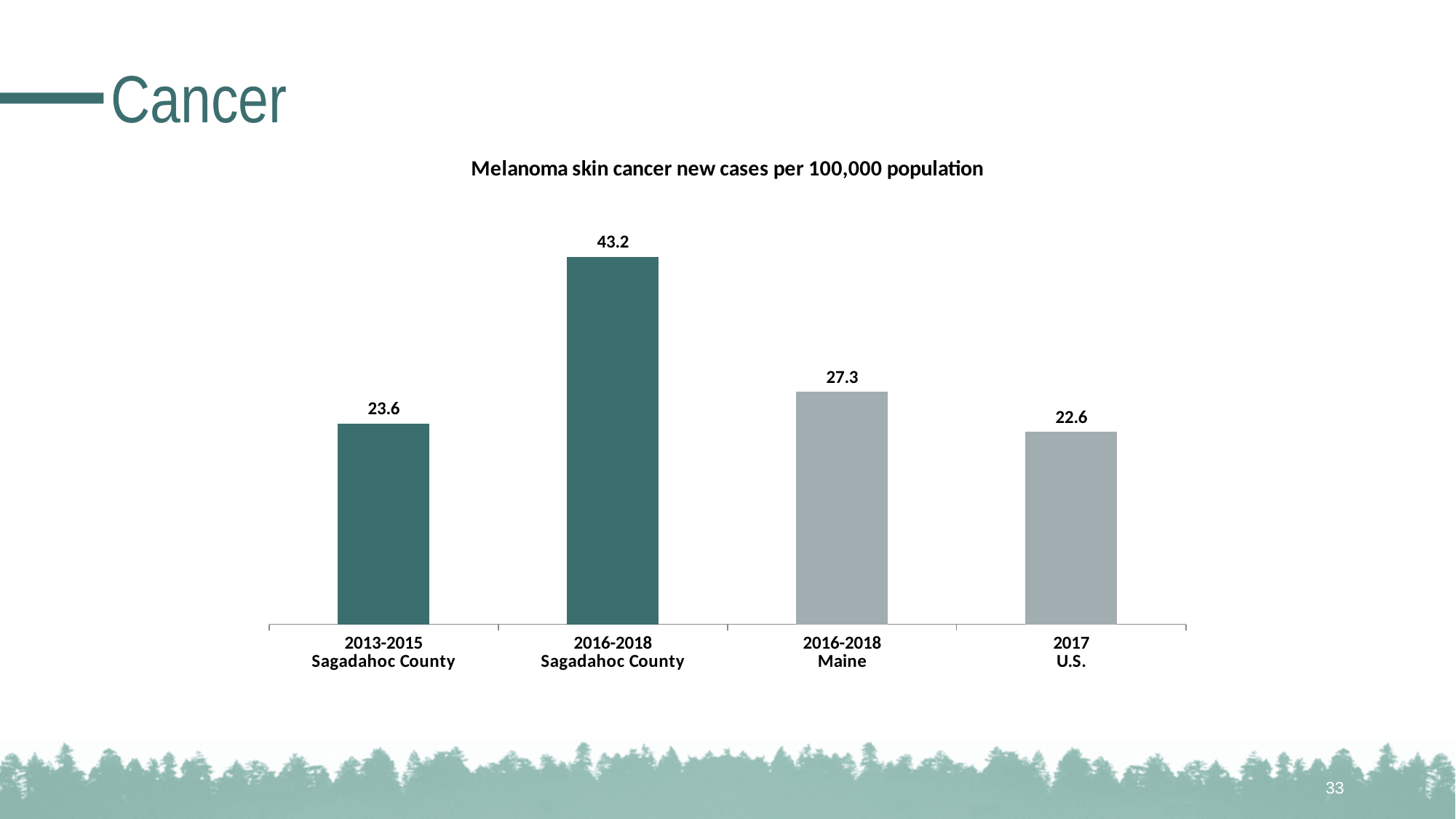
What is the melanoma skin cancer rate per 100,000 population for the U.S. in 2017? 22.6 What is the melanoma skin cancer rate per 100,000 population for Sagadahoc County in 2016-2018? 43.2 How many bars are shown in the chart? 4 What is the difference between the 2016-2018 Sagadahoc County rate and the 2016-2018 Maine rate? 15.9 What is the difference between the Sagadahoc County rates for 2016-2018 and 2013-2015? 19.6 What is the melanoma skin cancer rate per 100,000 population for Sagadahoc County in 2013-2015? 23.6 Which is larger, the 2016-2018 Maine rate or the 2017 U.S. rate? 2016-2018 Maine What kind of chart is shown on the slide? Bar chart What is the title of the chart? Melanoma skin cancer new cases per 100,000 population Which category has the highest melanoma skin cancer rate? 2016-2018 Sagadahoc County Which category has the lowest melanoma skin cancer rate? 2017 U.S. What is the melanoma skin cancer rate per 100,000 population for Maine in 2016-2018? 27.3